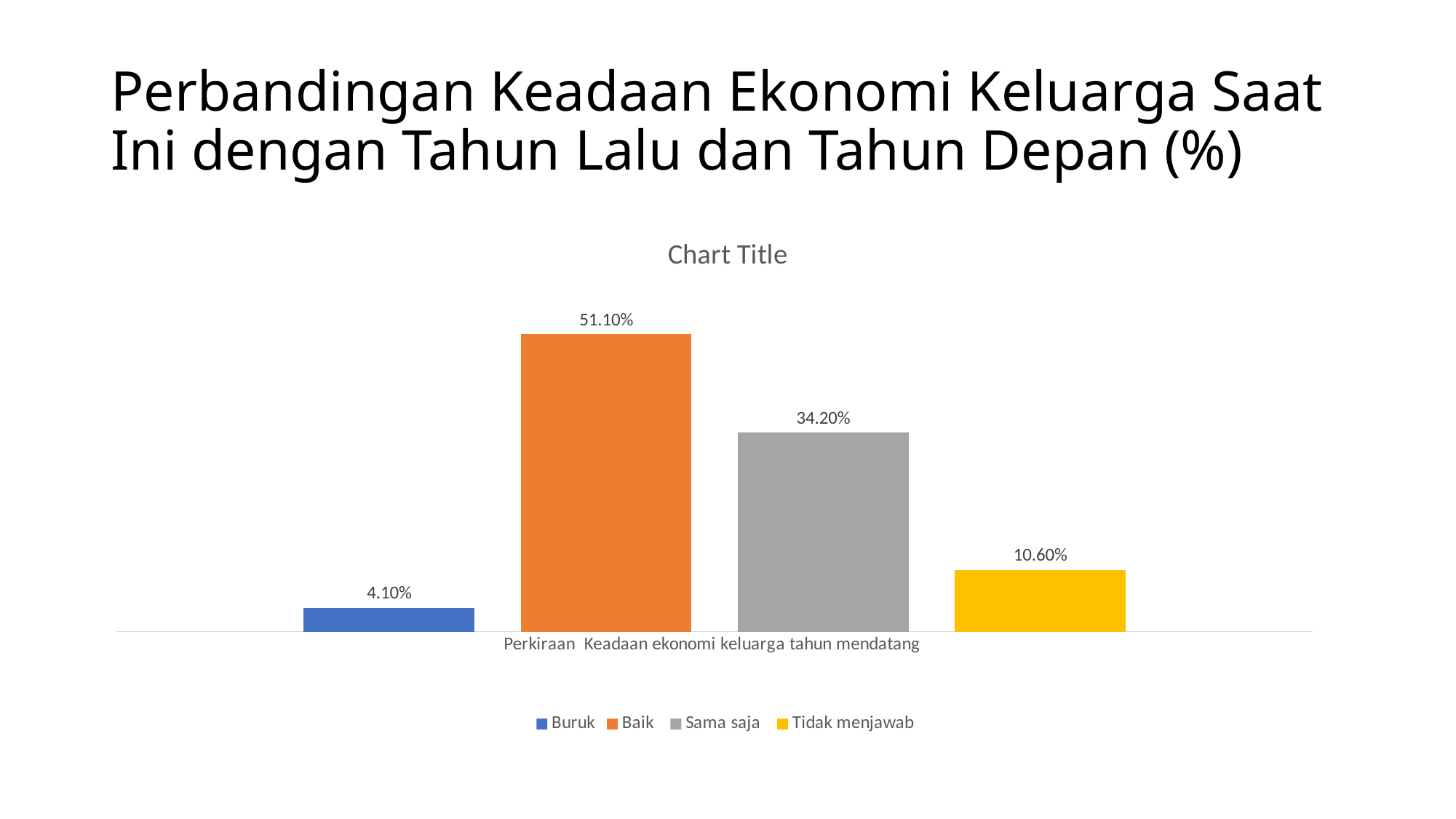
Which series has the lowest value? Buruk What is the difference between the values for Baik and Sama saja? 16.90% What is the category label shown on the x axis? Perkiraan Keadaan ekonomi keluarga tahun mendatang Which is larger, the value for Sama saja or the value for Tidak menjawab? Sama saja What is the value for Tidak menjawab? 10.60% How many series does the legend list? 4 What kind of chart is shown on the slide? Bar chart What is the value for Baik? 51.10% What is the difference between the values for Tidak menjawab and Buruk? 6.50% What is the value for Buruk? 4.10% Which series has the highest value? Baik What is the value for Sama saja? 34.20%